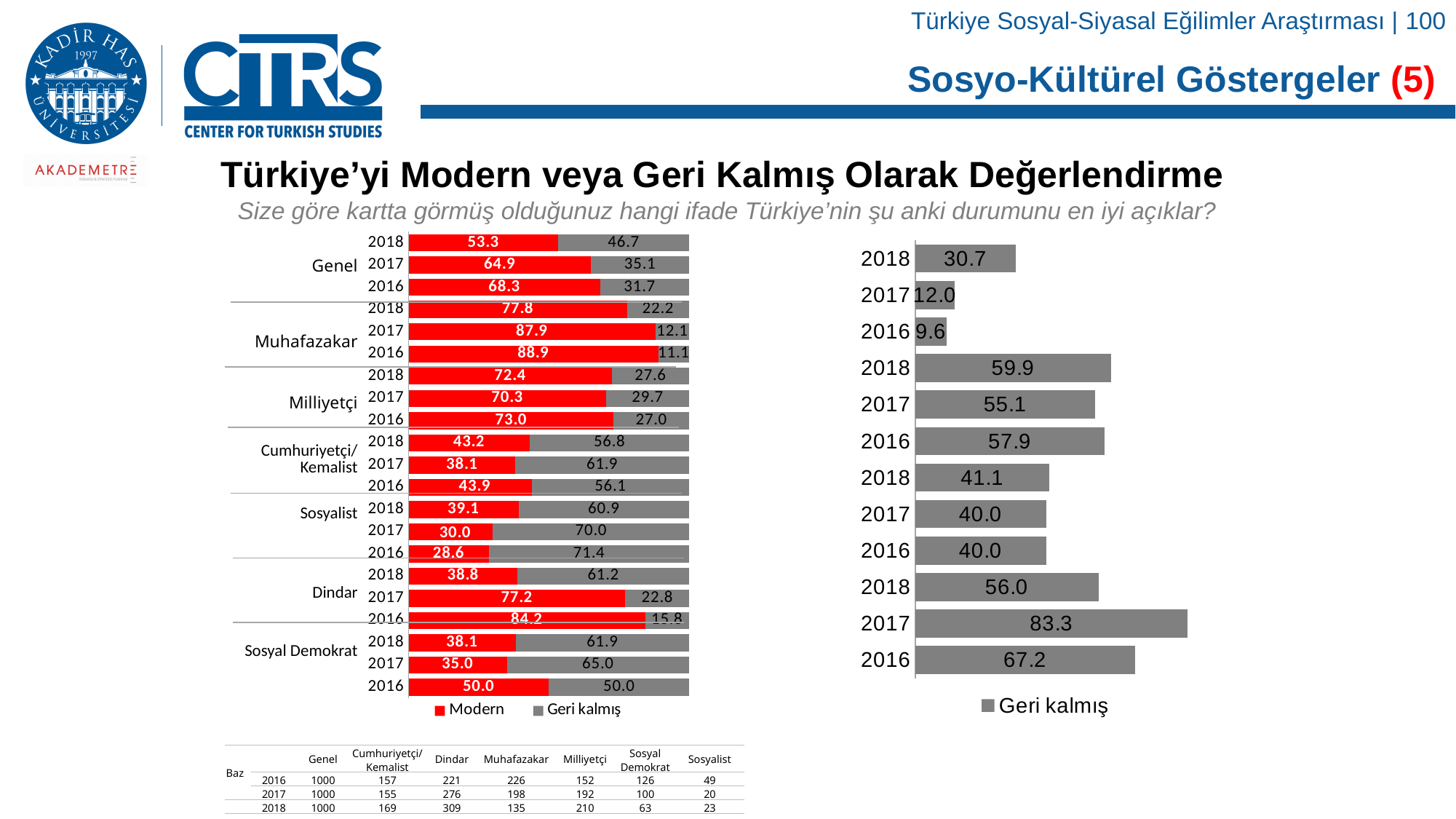
How many series does the legend of the left chart list? 2 How many bars are shown in the right bar chart? 12 In the left stacked bar chart, which group and year has the lowest Modern value? Sosyalist 2016 In the left stacked bar chart, which group and year has the highest Modern value? Muhafazakar 2016 In the left stacked bar chart, what is the Geri kalmış value for Muhafazakar in 2016? 11.1 In the left stacked bar chart, what is the difference between the Modern value for Dindar in 2017 and Dindar in 2018? 38.4 In the left stacked bar chart, what is the total of the Sosyal Demokrat 2016 bar? 100.0 In the left stacked bar chart, which is larger: the Modern value for Milliyetçi in 2018 or for Cumhuriyetçi/Kemalist in 2018? Milliyetçi 2018 What kind of chart is the left chart? Stacked bar chart In the right bar chart, what is the highest value shown? 83.3 In the left stacked bar chart, does the Modern value for Genel rise or fall from 2016 to 2018? Falls In the left stacked bar chart, what is the Modern value for Genel in 2018? 53.3